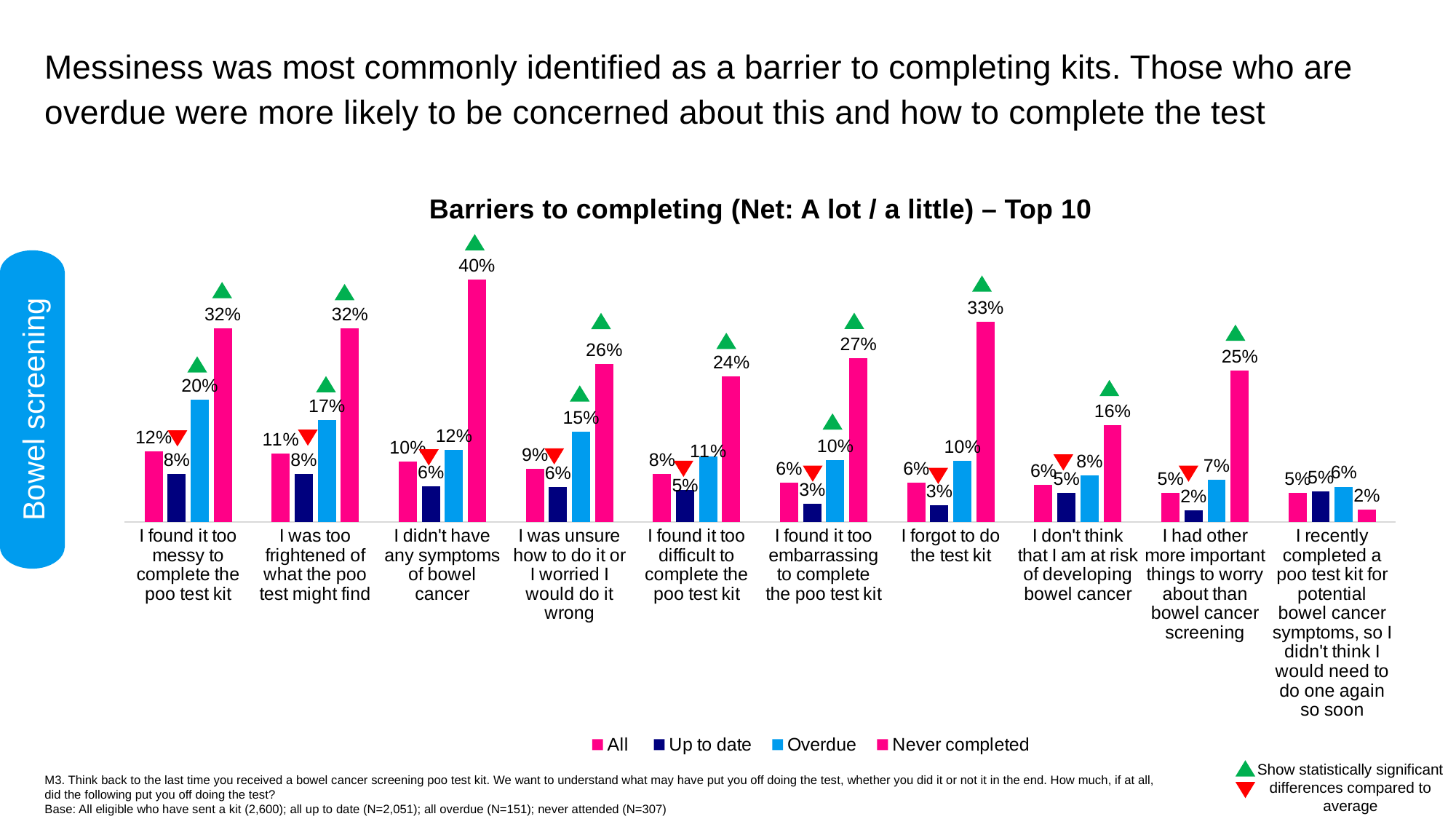
What is the title of the chart? Barriers to completing (Net: A lot / a little) – Top 10 Which barrier has the highest Never completed value? I didn't have any symptoms of bowel cancer What is the difference between the Overdue and Up to date values for 'I forgot to do the test kit'? 7 percentage points What is the Overdue value for 'I found it too messy to complete the poo test kit'? 20% Which barrier has the lowest Never completed value? I recently completed a poo test kit for potential bowel cancer symptoms, so I didn't think I would need to do one again so soon What is the difference between the Never completed and Up to date values for 'I found it too messy to complete the poo test kit'? 24 percentage points Which has a higher Overdue value: 'I was too frightened of what the poo test might find' or 'I was unsure how to do it or I worried I would do it wrong'? I was too frightened of what the poo test might find How many barrier categories are shown on the chart? 10 What is the All value for 'I forgot to do the test kit'? 6% How many series does the legend list? 4 What kind of chart is shown on the slide? Bar chart What is the Never completed value for 'I didn't have any symptoms of bowel cancer'? 40%